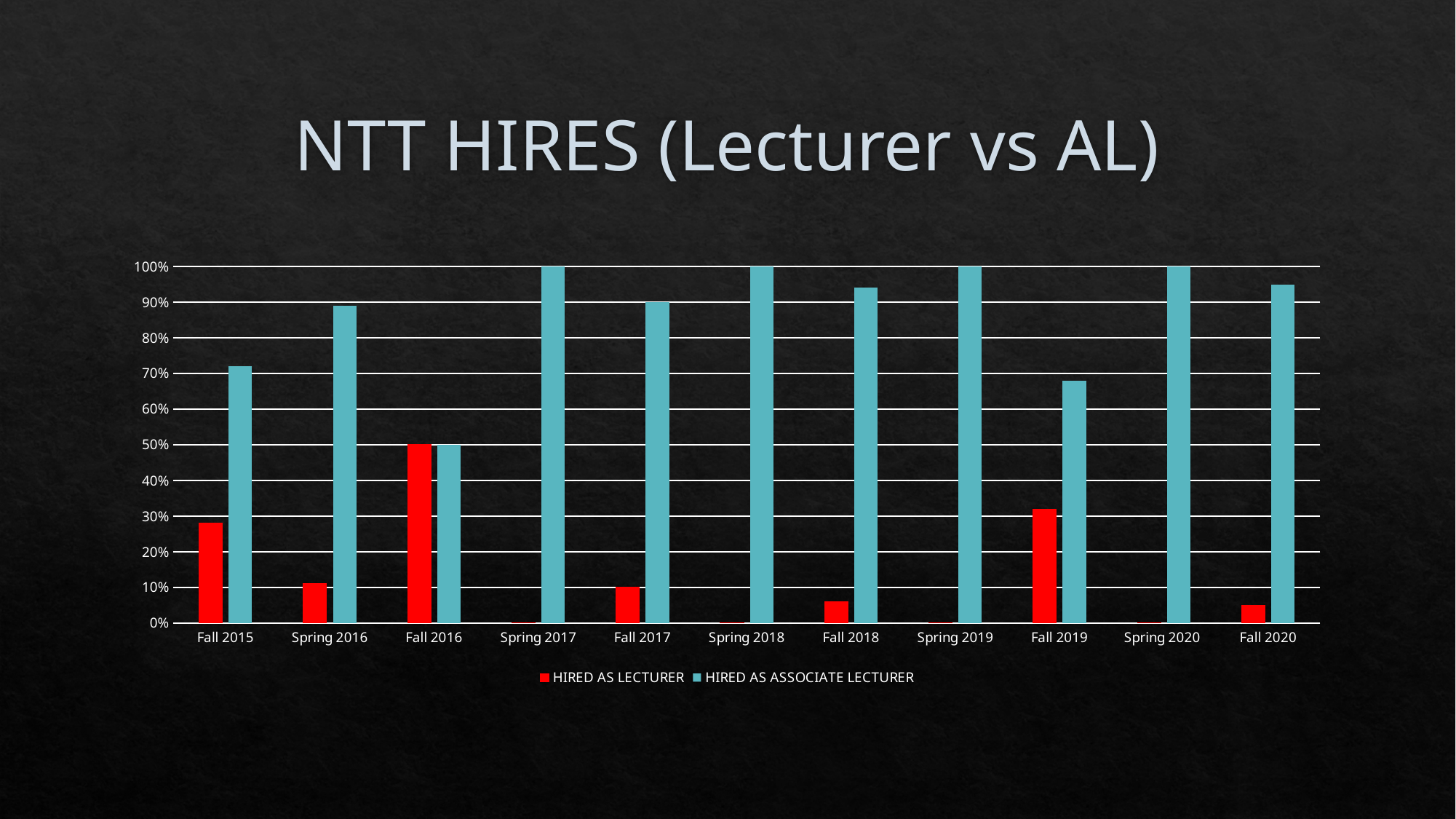
Is the value for HIRED AS LECTURER in Fall 2015 greater or less than 20%? greater What kind of chart is shown on the slide? bar chart In which semester is the HIRED AS ASSOCIATE LECTURER value lowest? Fall 2016 What is the value for HIRED AS ASSOCIATE LECTURER in Spring 2017? 100% In Fall 2015, which is larger: HIRED AS LECTURER or HIRED AS ASSOCIATE LECTURER? HIRED AS ASSOCIATE LECTURER How many semesters are shown along the x axis? 11 In which semester is the HIRED AS LECTURER value highest? Fall 2016 How many series does the legend list? 2 What colour are the HIRED AS LECTURER bars? red What is the value for HIRED AS LECTURER in Fall 2016? 50% Is the value for HIRED AS LECTURER in Fall 2020 greater or less than 10%? less Is the value for HIRED AS ASSOCIATE LECTURER in Fall 2019 greater or less than 80%? less